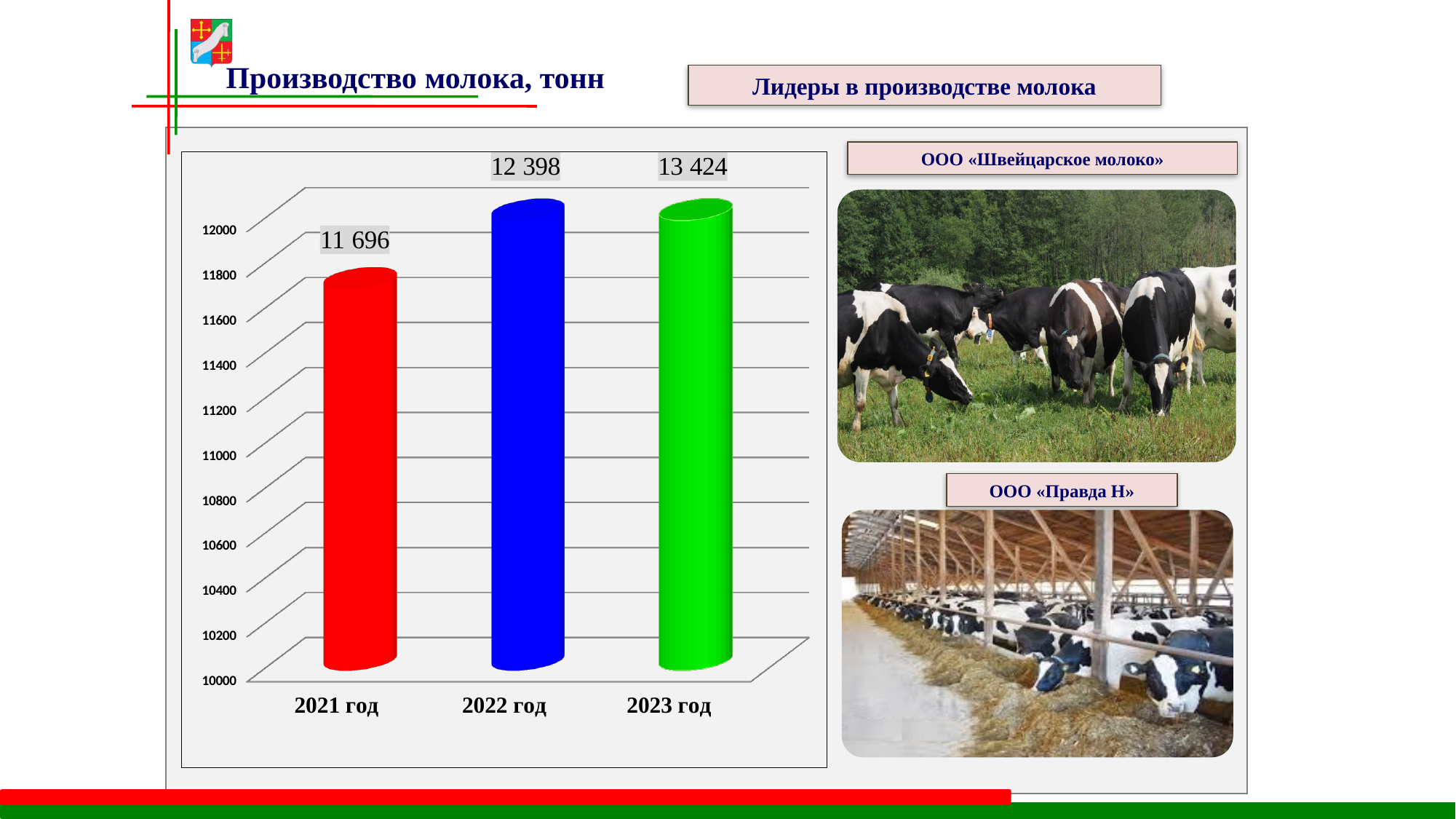
Which year has the lowest milk production on the chart? 2021 год What is the milk production value shown for 2022 год? 12 398 Do the milk production values rise or fall from 2021 год to 2023 год? rise What is the difference between the milk production values for 2022 год and 2021 год? 702 What is the milk production value shown for 2021 год? 11 696 How many years are shown on the chart? 3 What is the difference between the milk production values for 2023 год and 2022 год? 1 026 What is the milk production value shown for 2023 год? 13 424 Is the value for 2021 год greater or less than 12000? less What kind of chart is shown on the slide? bar chart Which is larger, the value for 2021 год or the value for 2022 год? 2022 год Which year has the highest milk production on the chart? 2023 год